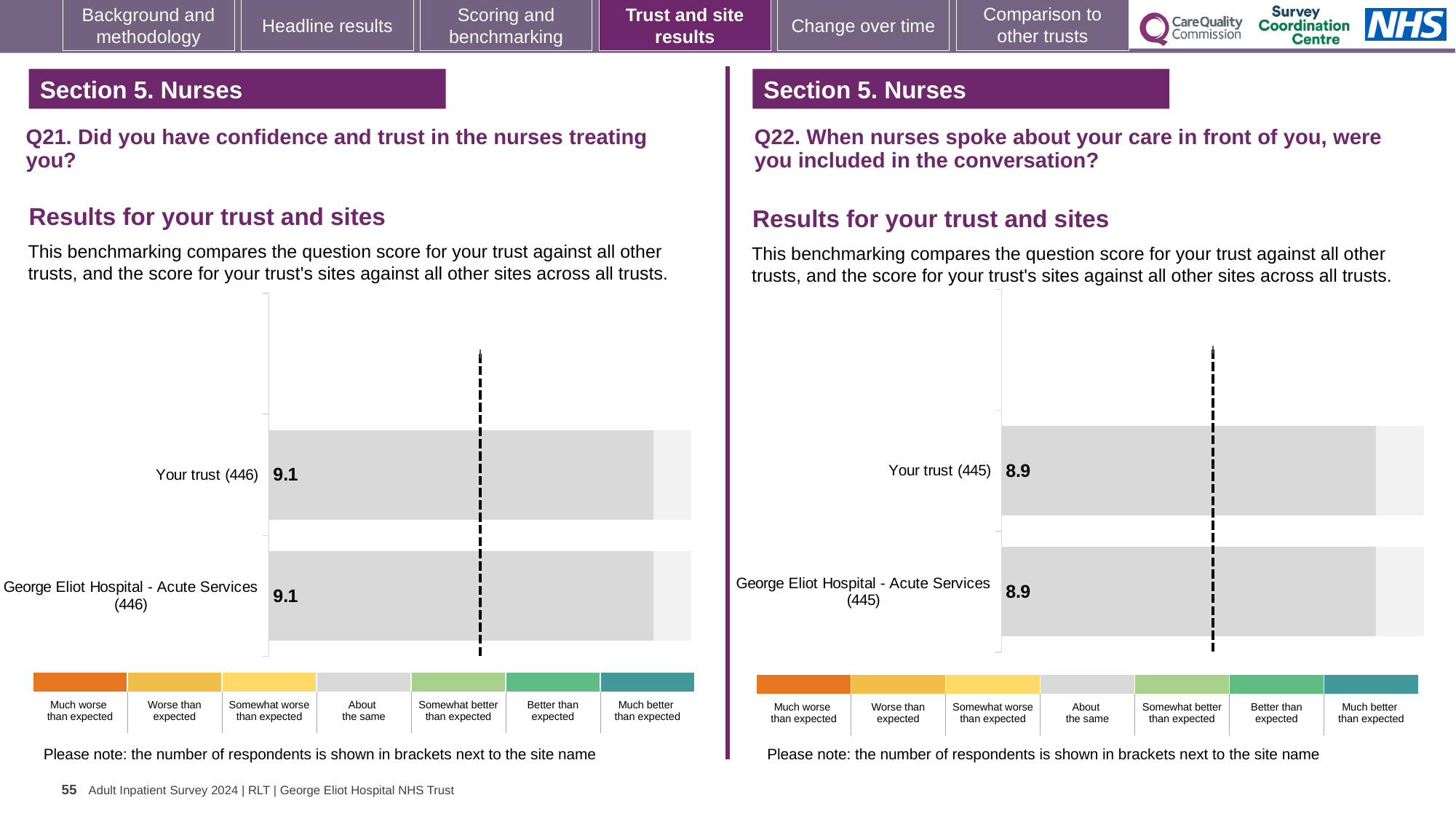
What is the difference between the Your trust score in the Q21 chart and the Your trust score in the Q22 chart? 0.2 In the Q22 chart on the right, how many respondents are shown in brackets for George Eliot Hospital - Acute Services? 445 In the Q21 chart on the left, what is the score for Your trust? 9.1 How many bars are plotted in the Q21 chart on the left? 2 In the Q22 chart on the right, what is the score for Your trust? 8.9 In the Q21 chart on the left, how many respondents are shown in brackets for Your trust? 446 In the Q21 chart on the left, what is the score for George Eliot Hospital - Acute Services? 9.1 How many bars are plotted in the Q22 chart on the right? 2 Which is larger: the Your trust score in the Q21 chart on the left or the Your trust score in the Q22 chart on the right? Q21 chart (9.1) In the Q22 chart on the right, what is the score for George Eliot Hospital - Acute Services? 8.9 What kind of chart is used for the Q21 results on the left? Bar chart